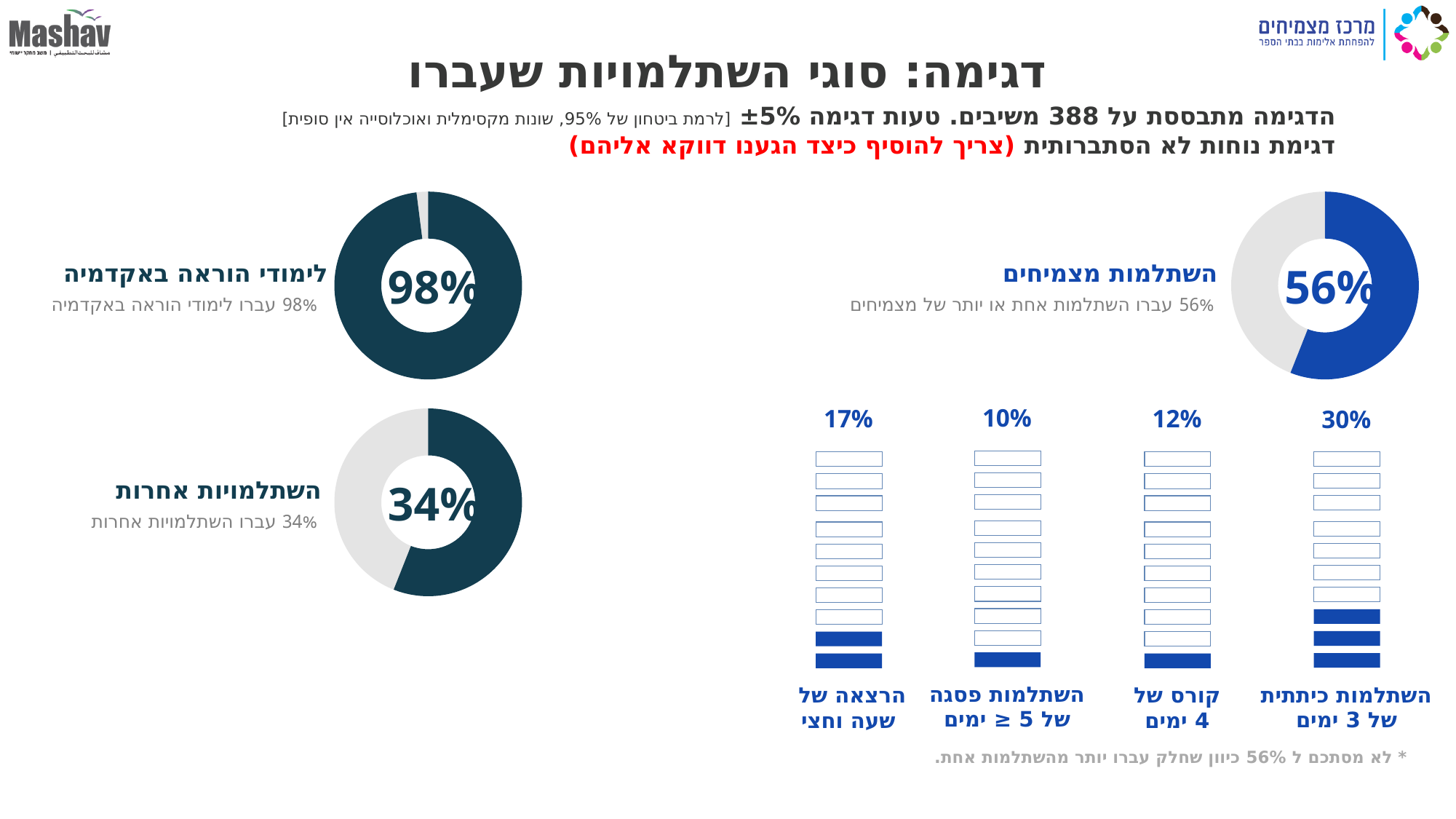
In the pictogram bar chart at the bottom right, what is the difference between the values for השתלמות כיתתית של 3 ימים and קורס של 4 ימים? 18% In the pictogram bar chart at the bottom right, which category has the highest value? השתלמות כיתתית של 3 ימים Which of the three donut charts shows the highest percentage? לימודי הוראה באקדמיה In the pictogram bar chart at the bottom right, what is the value for הרצאה של שעה וחצי? 17% In the donut chart labelled השתלמויות אחרות, what percentage is shown in the centre? 34% In the pictogram bar chart at the bottom right, which category has the lowest value? השתלמות פסגה של 5 ≥ ימים How many categories are shown in the pictogram bar chart at the bottom right? 4 In the donut chart labelled השתלמות מצמיחים, what percentage is shown in the centre? 56% In the pictogram bar chart at the bottom right, what is the value for השתלמות כיתתית של 3 ימים? 30% What is the difference between the percentages shown in the donut charts for לימודי הוראה באקדמיה and השתלמויות אחרות? 64% In the donut chart labelled לימודי הוראה באקדמיה, what percentage is shown in the centre? 98% In the pictogram bar chart at the bottom right, which is larger: the value for הרצאה של שעה וחצי or the value for קורס של 4 ימים? הרצאה של שעה וחצי